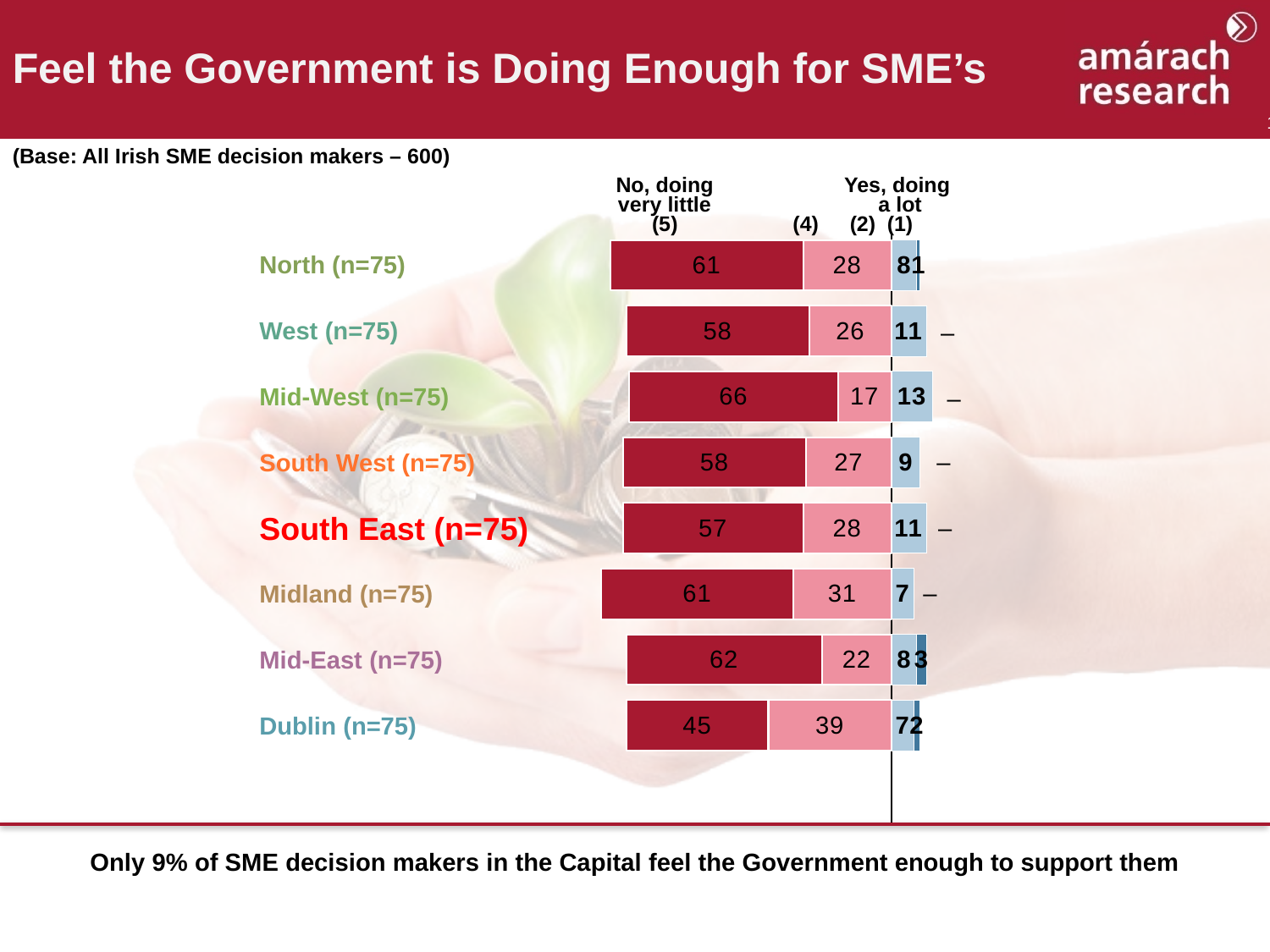
Which is larger, the (4) value for Dublin or the (4) value for Mid-East? Dublin What is the (4) value for Midland? 31 What is the difference between the (4) values for Midland and Mid-West? 14 What is the (4) value for Dublin? 39 Which region has the lowest 'No, doing very little (5)' value? Dublin What is the value for Dublin in the 'No, doing very little (5)' category? 45 What is the difference between the (5) values for Mid-West and Dublin? 21 What is the sample size (n) for each region shown in the chart? 75 What type of chart is shown on the slide? Stacked bar chart What percentage of Mid-West SME decision makers say the Government is doing very little (5)? 66 How many regions are shown in the chart? 8 Which region has the highest 'No, doing very little (5)' value? Mid-West